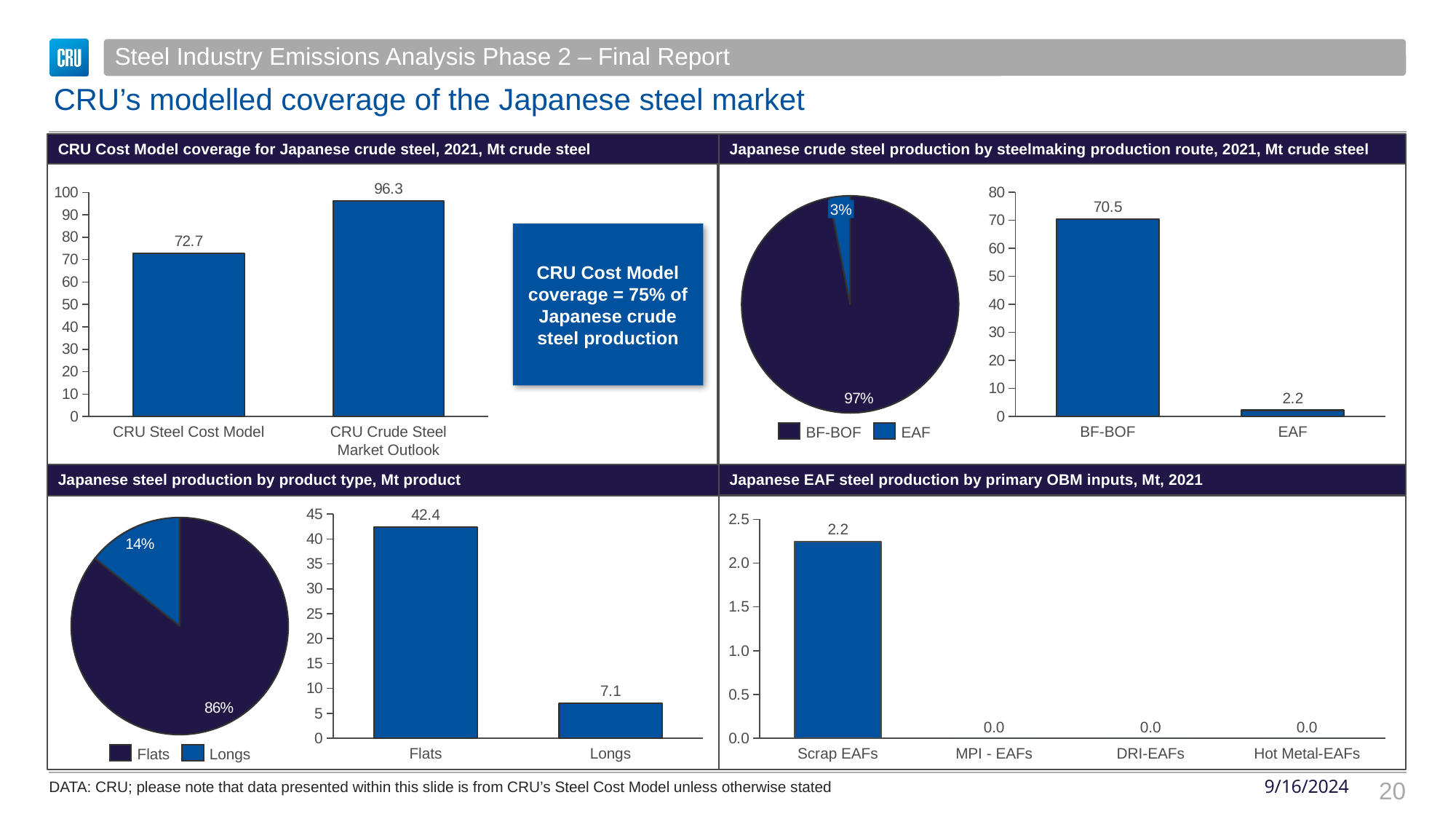
What kind of chart is the 'Japanese EAF steel production by primary OBM inputs, Mt, 2021' chart? Bar chart In the 'CRU Cost Model coverage for Japanese crude steel, 2021' chart, what is the value for CRU Crude Steel Market Outlook? 96.3 In the 'Japanese crude steel production by steelmaking production route, 2021' bar chart, which category is lowest? EAF In the 'Japanese crude steel production by steelmaking production route, 2021' pie chart, what share does EAF have? 3% In the 'CRU Cost Model coverage for Japanese crude steel, 2021' chart, what is the value for CRU Steel Cost Model? 72.7 In the 'Japanese steel production by product type' pie chart, what share do Flats have? 86% In the 'Japanese steel production by product type' bar chart, which is larger, Flats or Longs? Flats In the 'CRU Cost Model coverage for Japanese crude steel, 2021' chart, what is the difference between the CRU Crude Steel Market Outlook and CRU Steel Cost Model values? 23.6 In the 'Japanese EAF steel production by primary OBM inputs, Mt, 2021' chart, what is the value for Scrap EAFs? 2.2 How many categories are shown in the 'Japanese EAF steel production by primary OBM inputs, Mt, 2021' chart? 4 In the 'Japanese steel production by product type' bar chart, what is the value for Longs? 7.1 In the 'Japanese crude steel production by steelmaking production route, 2021' bar chart, what is the value for BF-BOF? 70.5